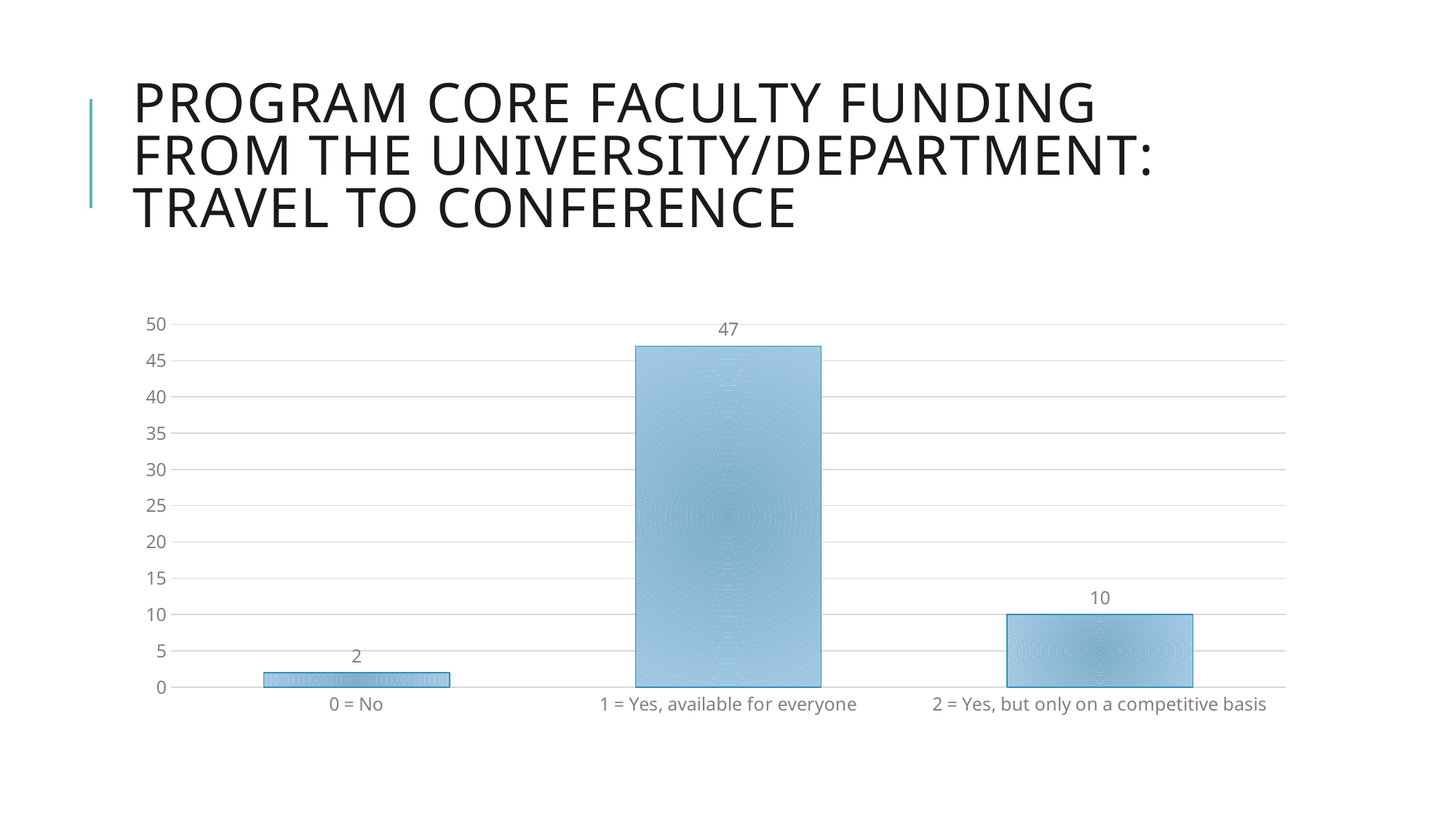
How many categories are shown on the x axis? 3 What is the title of the slide? Program Core Faculty Funding from the University/Department: Travel to Conference What is the value for "0 = No"? 2 What is the difference between the values for "1 = Yes, available for everyone" and "2 = Yes, but only on a competitive basis"? 37 What is the difference between the values for "2 = Yes, but only on a competitive basis" and "0 = No"? 8 Which is larger, the value for "2 = Yes, but only on a competitive basis" or the value for "0 = No"? 2 = Yes, but only on a competitive basis Is the value for "1 = Yes, available for everyone" greater or less than 40? greater Which category has the highest value? 1 = Yes, available for everyone What is the value for "1 = Yes, available for everyone"? 47 Which category has the lowest value? 0 = No What is the value for "2 = Yes, but only on a competitive basis"? 10 What kind of chart is shown on the slide? bar chart